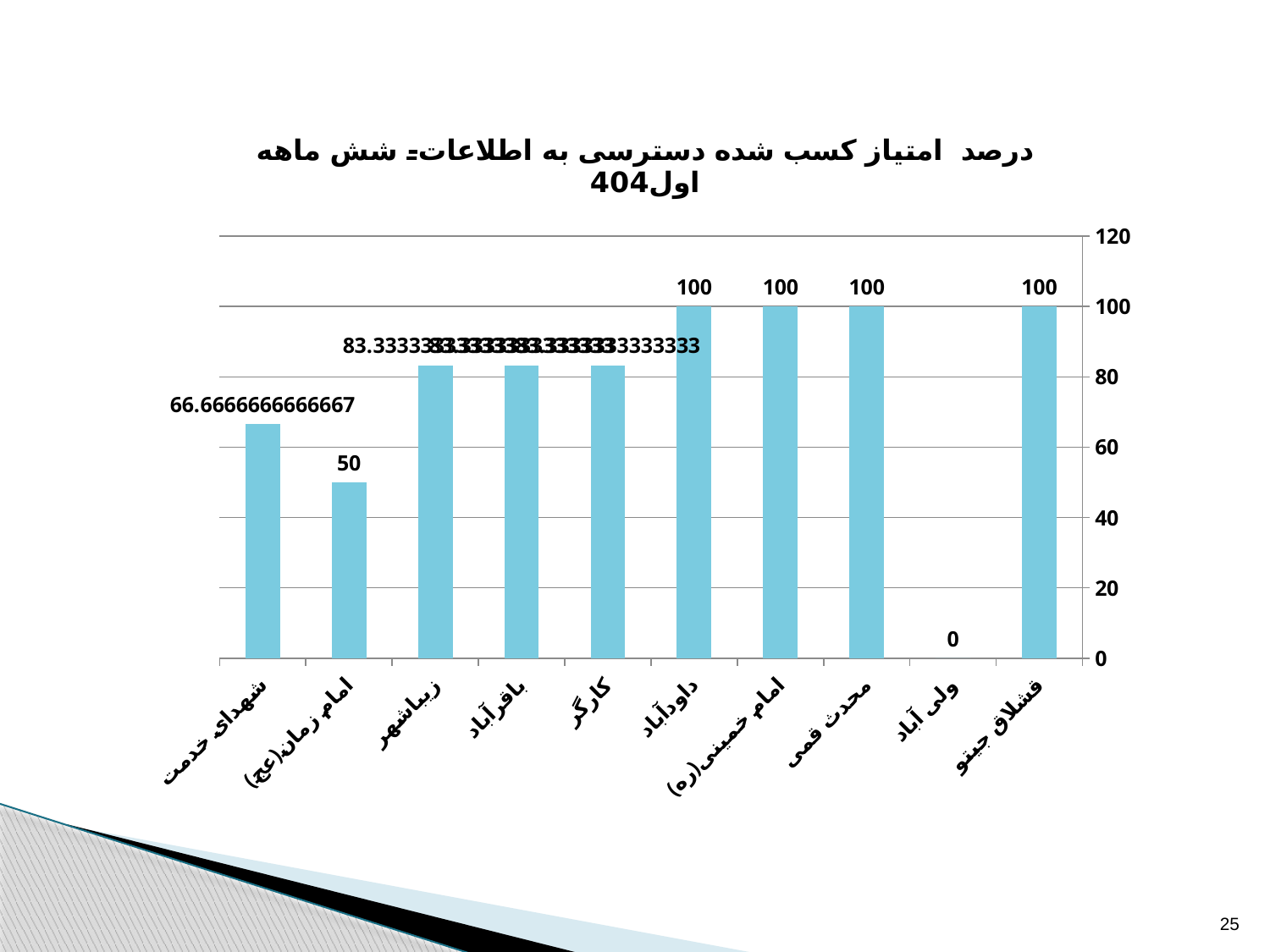
What is the value for امام زمان(عج)? 50 What is the value for داودآباد? 100 Is the value for زیباشهر greater or less than 80? greater What is the value for قشلاق جیتو? 100 How many categories (bars) are shown on the chart? 10 Is the value for کارگر greater or less than 100? less What type of chart is shown on the slide? bar chart What is the value for شهدای خدمت? 66.6666666666667 What is the value for ولی آباد? 0 Which category has the lowest value? ولی آباد What is the difference between the value for محدث قمی and the value for امام زمان(عج)? 50 Which is larger, the value for شهدای خدمت or the value for امام زمان(عج)? شهدای خدمت